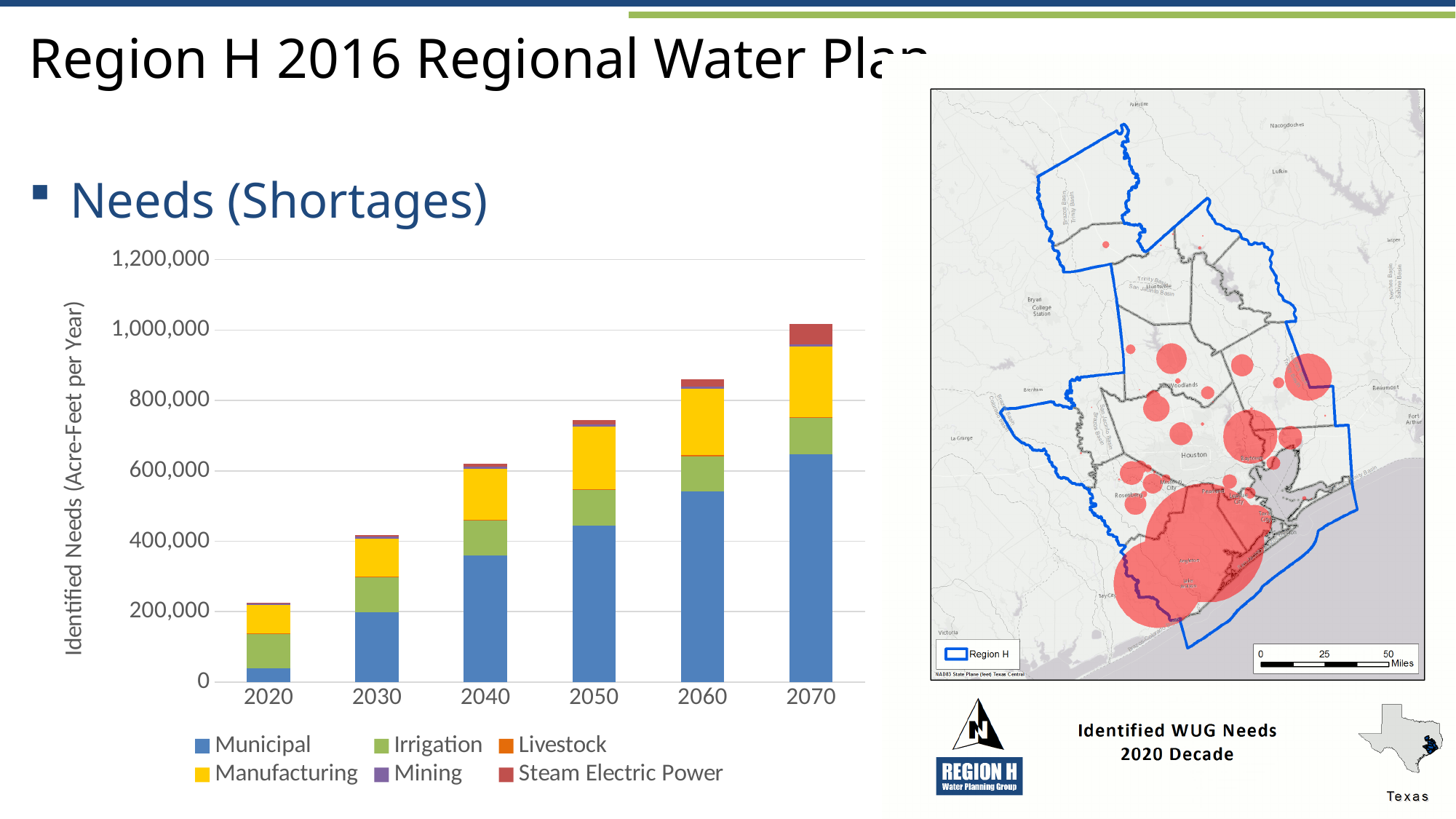
Which colour represents Municipal in the bar chart legend? Blue Is the total stacked bar for 2060 greater or less than 800,000? greater Which year has the tallest stacked bar in the chart? 2070 Which year has a larger total stacked bar, 2050 or 2060? 2060 Is the total stacked bar for 2050 greater or less than 800,000? less How many years (categories) are shown on the x axis of the bar chart? 6 Which year has the shortest stacked bar in the chart? 2020 Do the total identified needs rise or fall from 2020 to 2070? Rise Is the Municipal value for 2070 greater or less than 600,000? greater What kind of chart is shown under the heading "Needs (Shortages)"? Stacked bar chart What is the title of the vertical axis of the bar chart? Identified Needs (Acre-Feet per Year) How many series does the legend of the bar chart list? 6